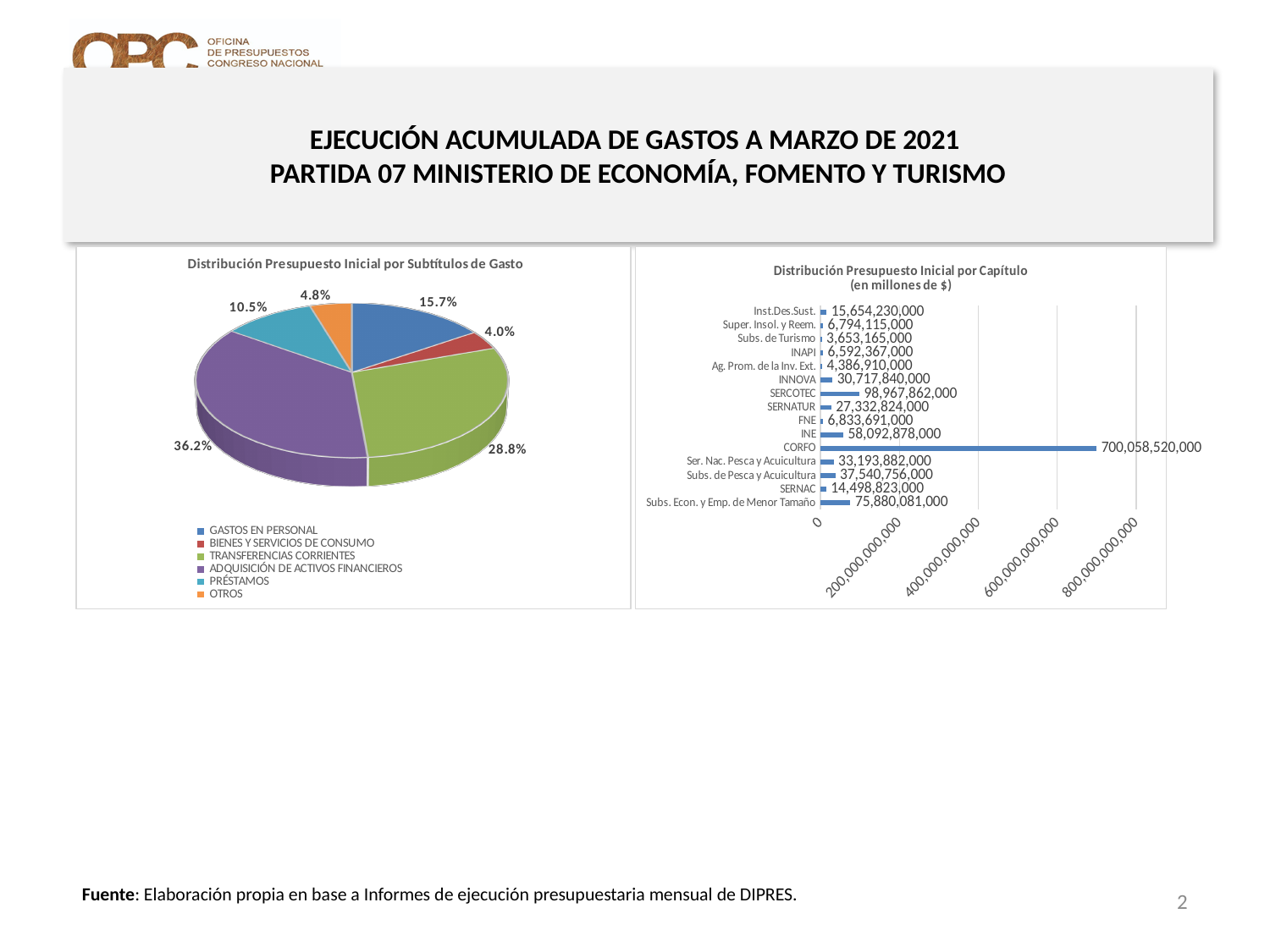
In the chart 'Distribución Presupuesto Inicial por Capítulo', what is the value for SERCOTEC? 98,967,862,000 In the chart 'Distribución Presupuesto Inicial por Subtítulos de Gasto', which category has the smallest share? BIENES Y SERVICIOS DE CONSUMO In the chart 'Distribución Presupuesto Inicial por Capítulo', which chapter has the lowest value? Subs. de Turismo How many categories does the legend of the chart 'Distribución Presupuesto Inicial por Subtítulos de Gasto' list? 6 In the chart 'Distribución Presupuesto Inicial por Capítulo', which chapter has the highest value? CORFO In the chart 'Distribución Presupuesto Inicial por Subtítulos de Gasto', what share does TRANSFERENCIAS CORRIENTES have? 28.8% In the chart 'Distribución Presupuesto Inicial por Capítulo', which is larger: INE or INNOVA? INE In the chart 'Distribución Presupuesto Inicial por Capítulo', what is the difference between Subs. de Pesca y Acuicultura and Ser. Nac. Pesca y Acuicultura? 4,346,874,000 In the chart 'Distribución Presupuesto Inicial por Subtítulos de Gasto', what share does ADQUISICIÓN DE ACTIVOS FINANCIEROS have? 36.2% In the chart 'Distribución Presupuesto Inicial por Capítulo', what is the value for CORFO? 700,058,520,000 What kind of chart is 'Distribución Presupuesto Inicial por Subtítulos de Gasto'? Pie chart What kind of chart is 'Distribución Presupuesto Inicial por Capítulo'? Bar chart